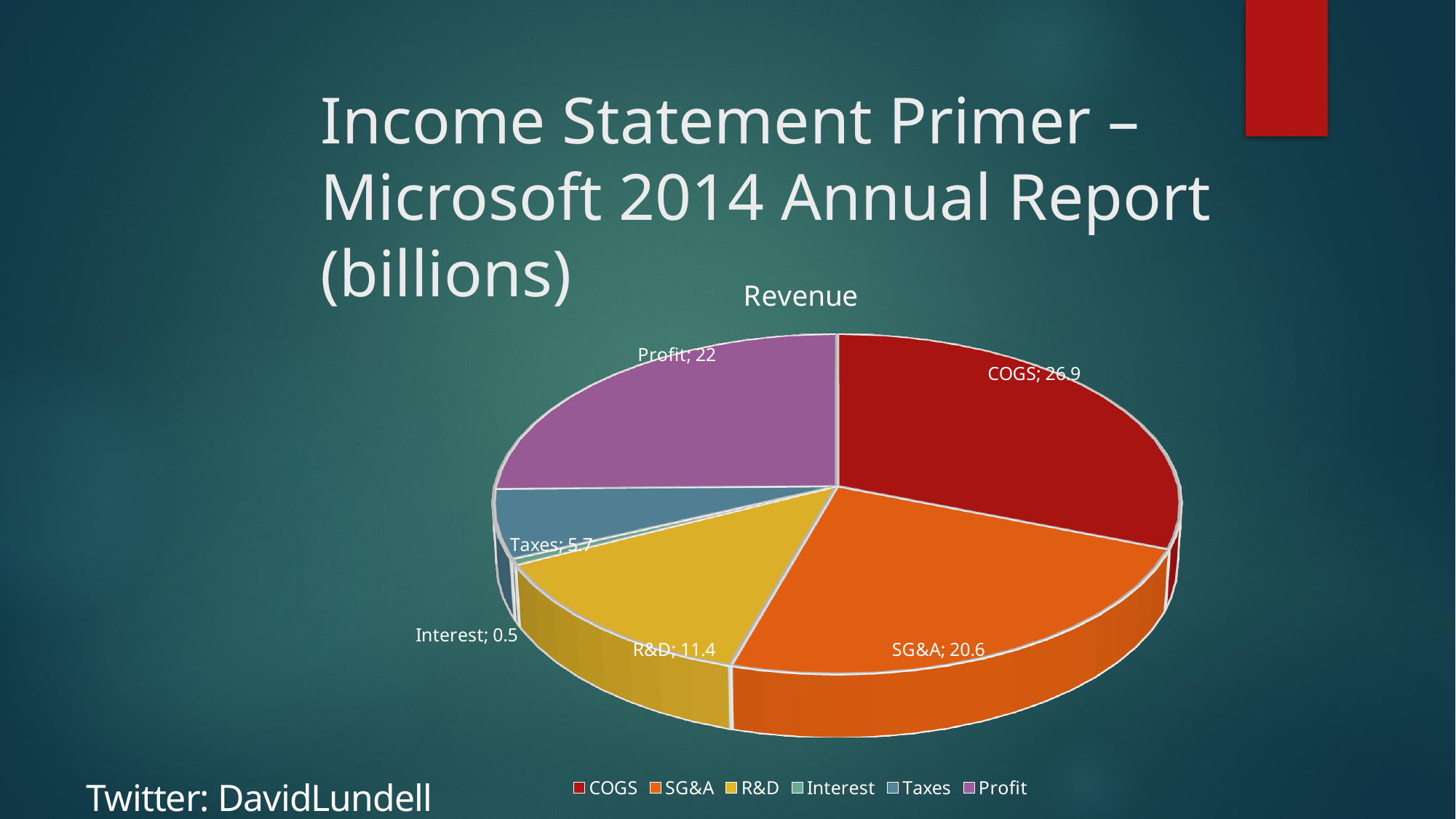
Which category has the largest slice in the Revenue pie chart? COGS What type of chart is shown on the slide? Pie chart What is the value of the Interest slice in the Revenue pie chart? 0.5 What is the sum of all slice values in the Revenue pie chart? 87.1 Which is larger in the Revenue pie chart, R&D or Taxes? R&D What is the difference between the COGS and SG&A values in the Revenue pie chart? 6.3 How many slices does the Revenue pie chart have? 6 What is the difference between the Profit and Taxes values in the Revenue pie chart? 16.3 Which category has the smallest slice in the Revenue pie chart? Interest What is the value of the Profit slice in the Revenue pie chart? 22 What is the value of the COGS slice in the Revenue pie chart? 26.9 What is the title of the chart on the slide? Revenue